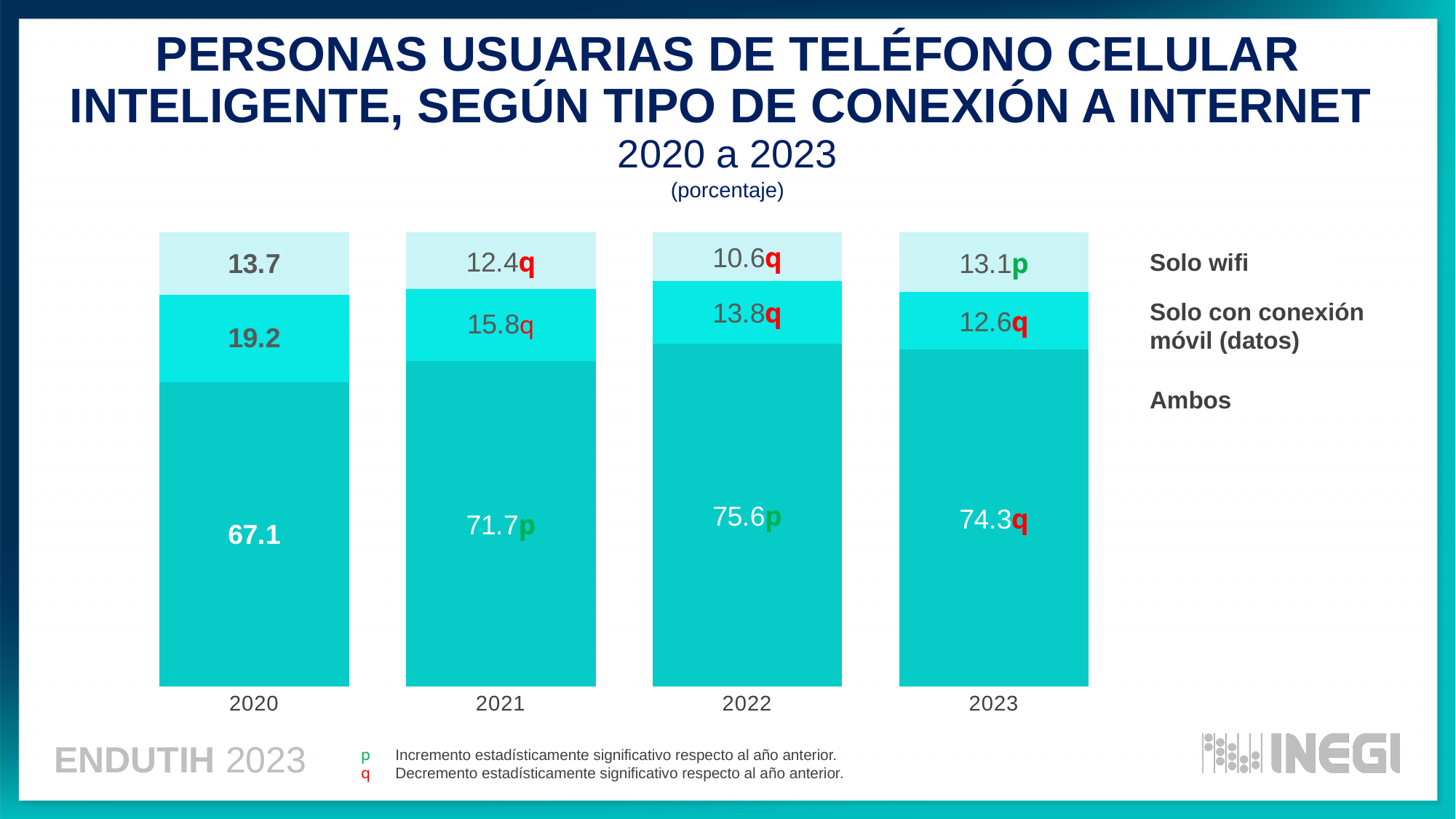
What kind of chart is shown on the slide? Stacked bar chart How many series does the legend list? 3 What is the difference between the Ambos value in 2022 and in 2020? 8.5 What is the value for Ambos in 2020? 67.1 In which year is the value for Ambos highest? 2022 Does the value for Solo con conexión móvil (datos) rise or fall from 2020 to 2023? Fall How many years are shown on the x axis? 4 What is the value for Solo con conexión móvil (datos) in 2023? 12.6 What is the total of the stacked bar for 2021? 99.9 What is the value for Solo wifi in 2022? 10.6 Which is larger in 2021: Solo wifi or Solo con conexión móvil (datos)? Solo con conexión móvil (datos) In which year is the value for Solo con conexión móvil (datos) lowest? 2023